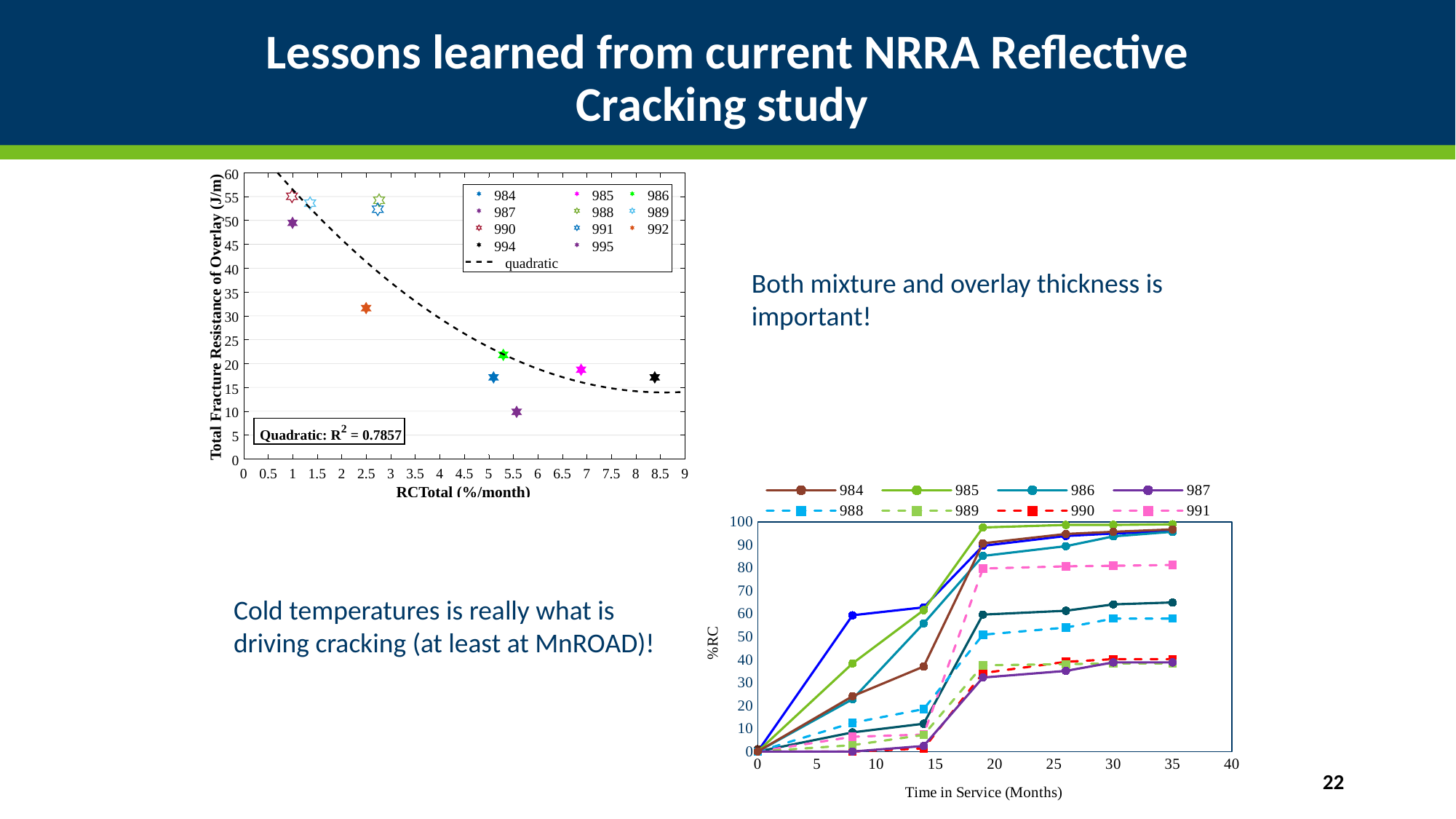
In the left scatter plot, what is the R-squared value of the quadratic fit? 0.7857 What kind of chart is the chart on the bottom right of the slide? Line chart In the left scatter plot, which series has the lowest Total Fracture Resistance of Overlay? 995 In the bottom-right line chart, is the %RC for series 991 at 35 months greater or less than 70? greater In the left scatter plot, which series has the highest RCTotal value? 994 In the left scatter plot, does Total Fracture Resistance of Overlay rise or fall as RCTotal increases? Fall What kind of chart is the chart on the left of the slide? Scatter plot In the left scatter plot, is the Total Fracture Resistance of Overlay for series 992 greater or less than 25? greater In the left scatter plot, what is the label of the x axis? RCTotal (%/month) In the bottom-right line chart, what is the label of the x axis? Time in Service (Months) In the bottom-right line chart, is the %RC for series 987 at 35 months greater or less than 50? less How many series does the legend of the bottom-right line chart list? 8